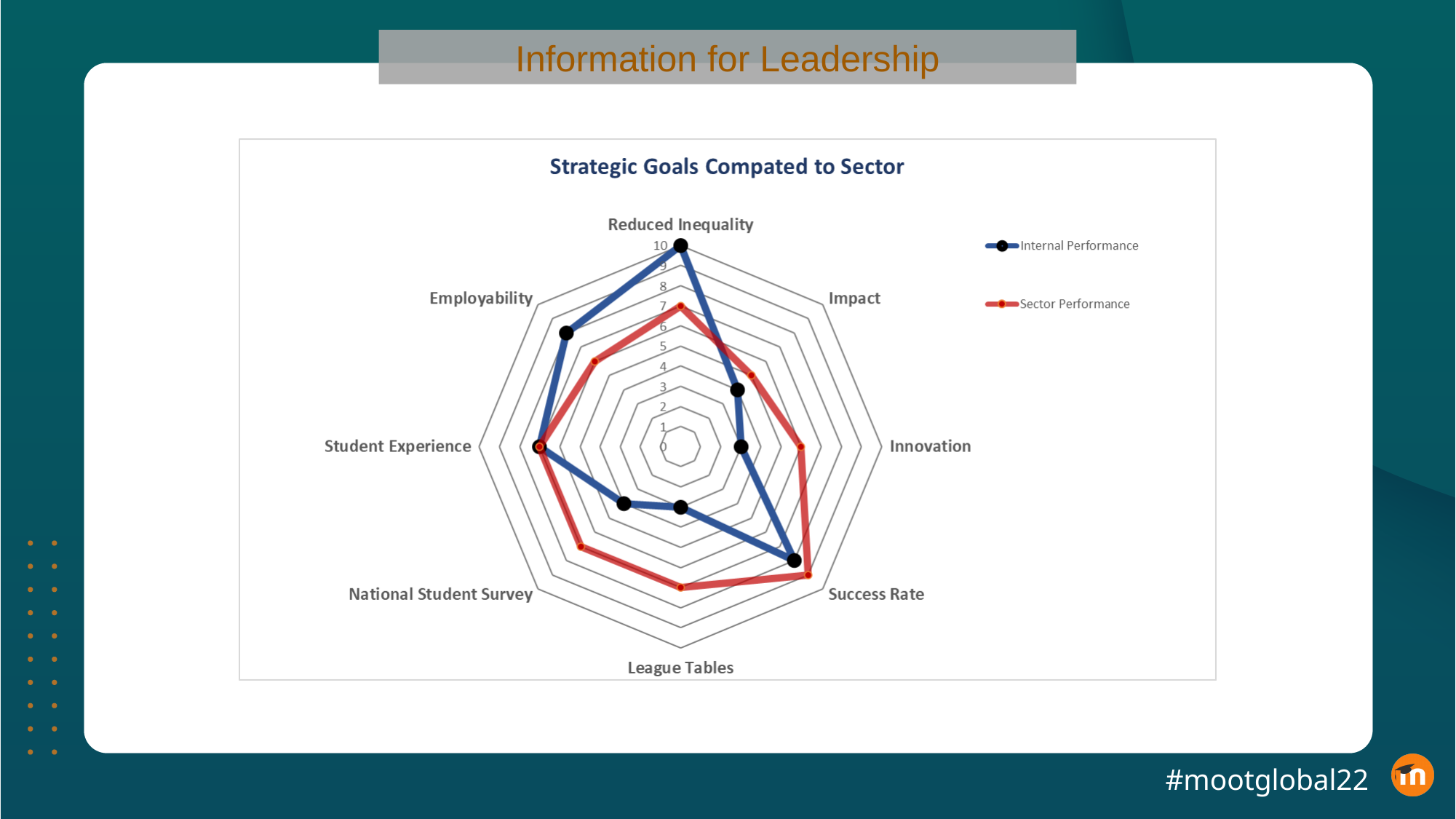
Is the Internal Performance value for Innovation greater or less than 5? less Is the Sector Performance value for Innovation greater or less than 5? greater For Impact, which series has the larger value, Internal Performance or Sector Performance? Sector Performance What is the Internal Performance value for Reduced Inequality? 10 For Reduced Inequality, which series has the larger value, Internal Performance or Sector Performance? Internal Performance What is the title of the chart? Strategic Goals Compated to Sector How many categories are plotted around the radar chart? 8 What is the Sector Performance value for Reduced Inequality? 7 What kind of chart is shown on the slide? Radar chart How many series does the legend list? 2 Which category has the highest Internal Performance value? Reduced Inequality